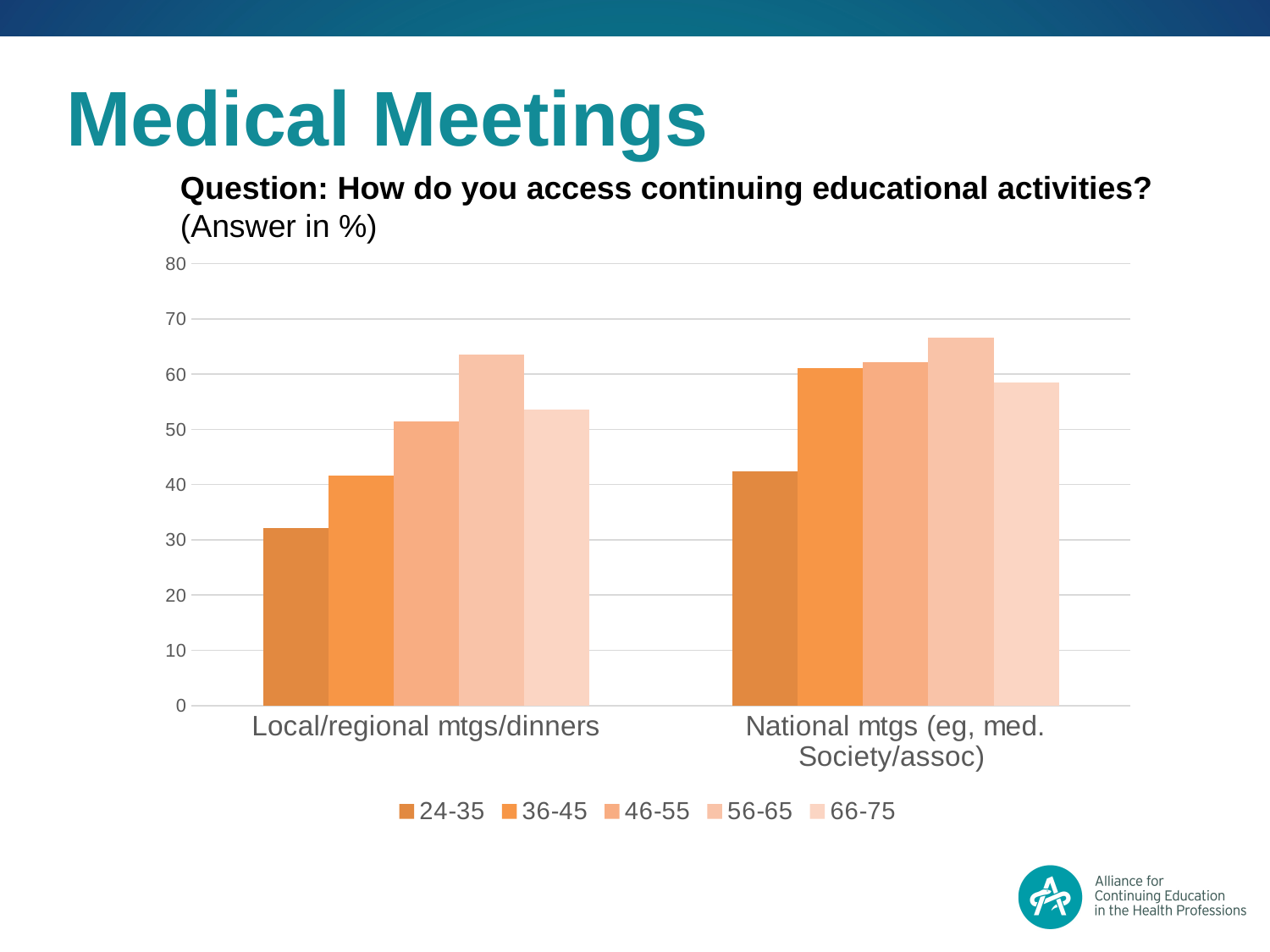
Which age group has the lowest value for National mtgs (eg, med. Society/assoc)? 24-35 What are the age groups listed in the legend? 24-35, 36-45, 46-55, 56-65, 66-75 How many categories are shown on the x axis? 2 Is the value for the 24-35 group for Local/regional mtgs/dinners greater or less than 40? less What kind of chart is shown on the slide? bar chart For the 36-45 group, which category has the larger value: Local/regional mtgs/dinners or National mtgs (eg, med. Society/assoc)? National mtgs (eg, med. Society/assoc) Is the value for the 56-65 group for National mtgs (eg, med. Society/assoc) greater or less than 60? greater Which age group has the highest value for Local/regional mtgs/dinners? 56-65 Is the value for the 36-45 group for National mtgs (eg, med. Society/assoc) greater or less than 50? greater How many series does the legend list? 5 Which age group has the lowest value for Local/regional mtgs/dinners? 24-35 Which age group has the highest value for National mtgs (eg, med. Society/assoc)? 56-65